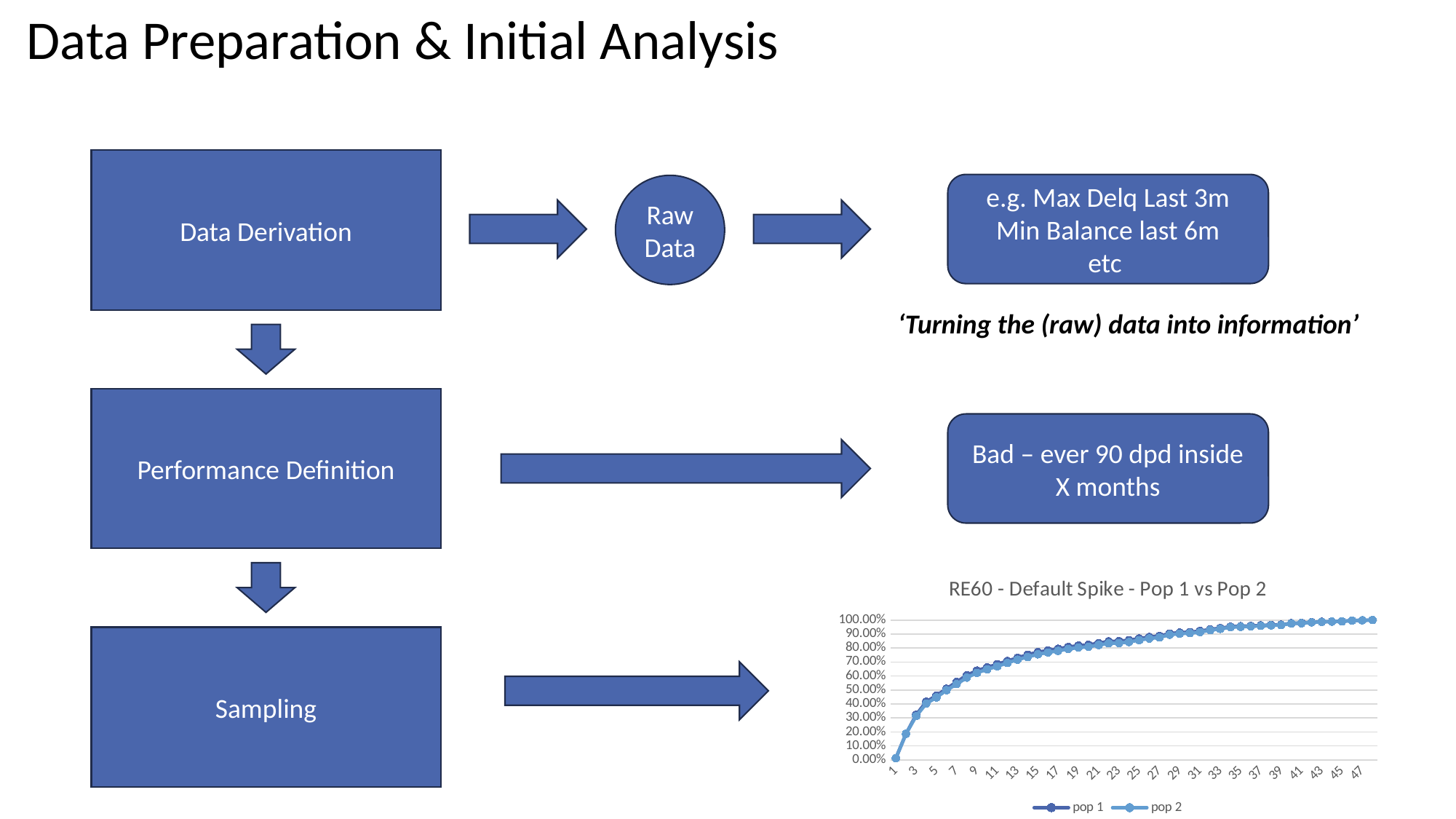
What are the two series named in the legend of the 'RE60 - Default Spike - Pop 1 vs Pop 2' chart? pop 1 and pop 2 What kind of chart is 'RE60 - Default Spike - Pop 1 vs Pop 2'? line chart In the 'RE60 - Default Spike - Pop 1 vs Pop 2' chart, is the value for pop 2 at x = 3 greater or less than 50.00%? less How many series does the legend of the 'RE60 - Default Spike - Pop 1 vs Pop 2' chart list? 2 In the 'RE60 - Default Spike - Pop 1 vs Pop 2' chart, is the value for pop 1 at x = 13 greater or less than 50.00%? greater In the 'RE60 - Default Spike - Pop 1 vs Pop 2' chart, is the value for pop 1 at x = 47 greater or less than 90.00%? greater In the 'RE60 - Default Spike - Pop 1 vs Pop 2' chart, do the values rise or fall as you move along the x axis? rise In the 'RE60 - Default Spike - Pop 1 vs Pop 2' chart, which is larger: the value at x = 5 or the value at x = 35? x = 35 What is the title of the chart on the slide? RE60 - Default Spike - Pop 1 vs Pop 2 What is the highest value shown on the y axis of the 'RE60 - Default Spike - Pop 1 vs Pop 2' chart? 100.00%